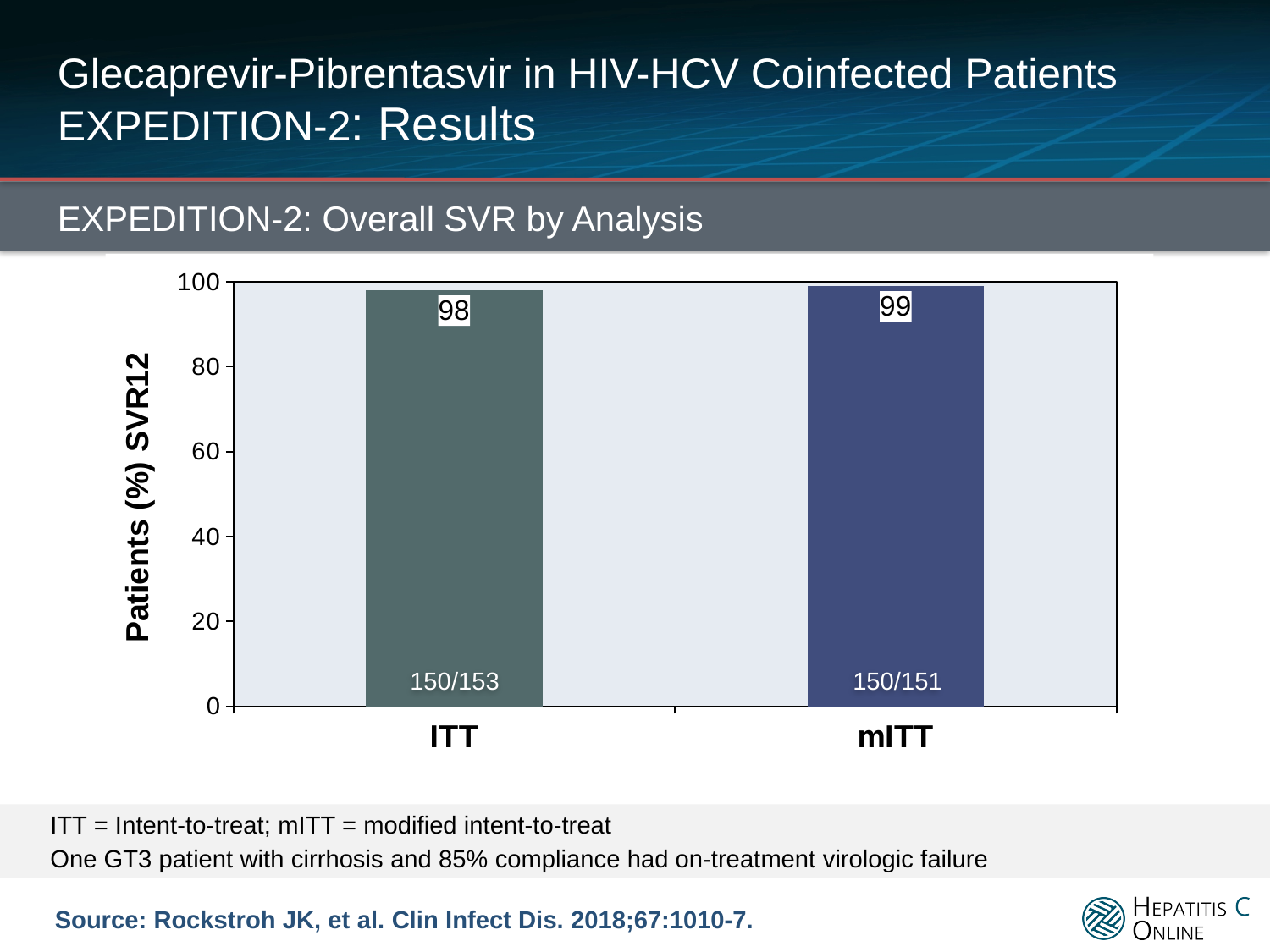
What fraction of patients is printed on the ITT bar? 150/153 What is the SVR12 value for ITT? 98 What is the label of the y axis? Patients (%) SVR12 What kind of chart is shown? Bar chart Which analysis has the lower SVR12 value? ITT Which analysis has the higher SVR12 value? mITT What is the title of the chart? EXPEDITION-2: Overall SVR by Analysis Is the SVR12 value for ITT greater or less than 80? greater What is the difference between the mITT and ITT SVR12 values? 1 What fraction of patients is printed on the mITT bar? 150/151 How many categories are shown on the x axis? 2 What is the SVR12 value for mITT? 99